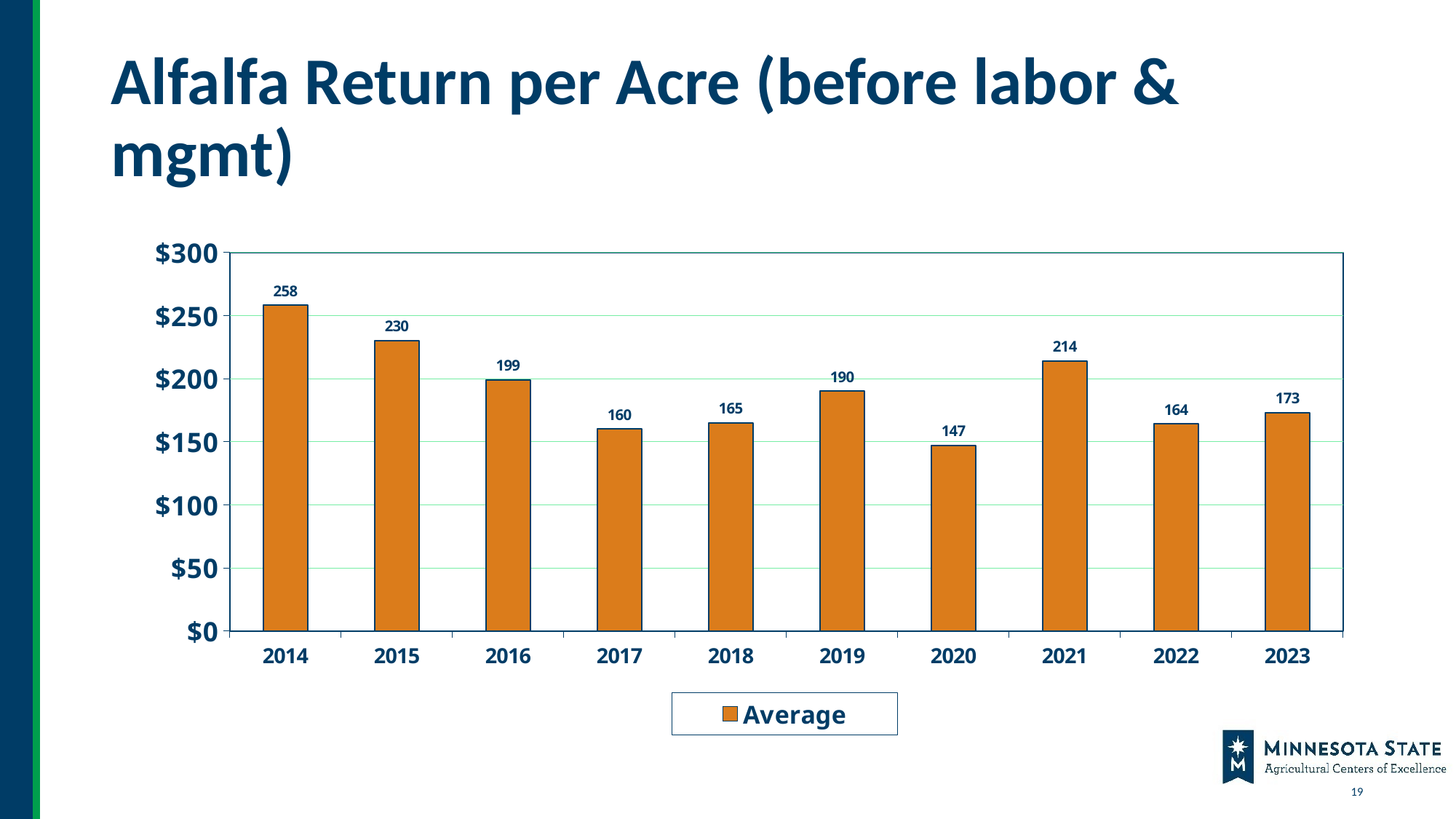
What is the difference between the average return per acre in 2014 and in 2015? 28 What is the average alfalfa return per acre for 2023? 173 Which year has the lowest average alfalfa return per acre? 2020 How many series does the legend list? 1 How many years are shown on the x axis of the chart? 10 What is the average alfalfa return per acre for 2020? 147 What is the difference between the average return per acre in 2021 and in 2022? 50 What kind of chart is shown on the slide? bar chart Which year has a higher average return per acre, 2019 or 2021? 2021 Which year has the highest average alfalfa return per acre? 2014 Is the average return per acre for 2016 greater or less than $150? greater What is the average alfalfa return per acre for 2014? 258